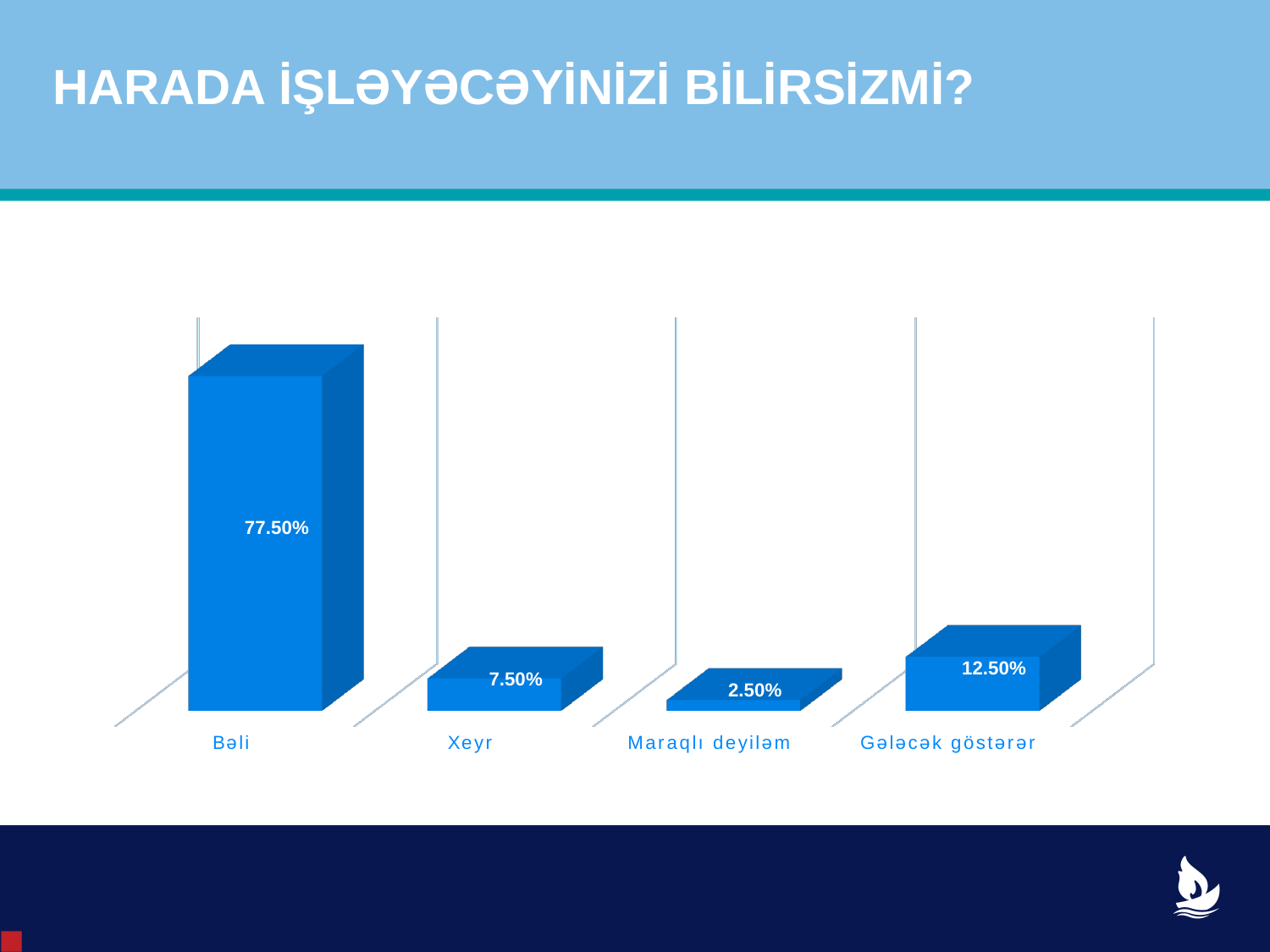
What is the difference between the values for Bəli and Gələcək göstərər? 65.00% What kind of chart is shown on the slide? Bar chart Which category has the highest value? Bəli What is the value for Xeyr? 7.50% What is the value for Gələcək göstərər? 12.50% How many categories are shown in the chart? 4 What is the difference between the values for Xeyr and Maraqlı deyiləm? 5.00% What is the value for Bəli? 77.50% Which category has the lowest value? Maraqlı deyiləm Which is larger, the value for Xeyr or the value for Gələcək göstərər? Gələcək göstərər What is the value for Maraqlı deyiləm? 2.50% What is the title of the slide? HARADA İŞLƏYƏCƏYİNİZİ BİLİRSİZMİ?